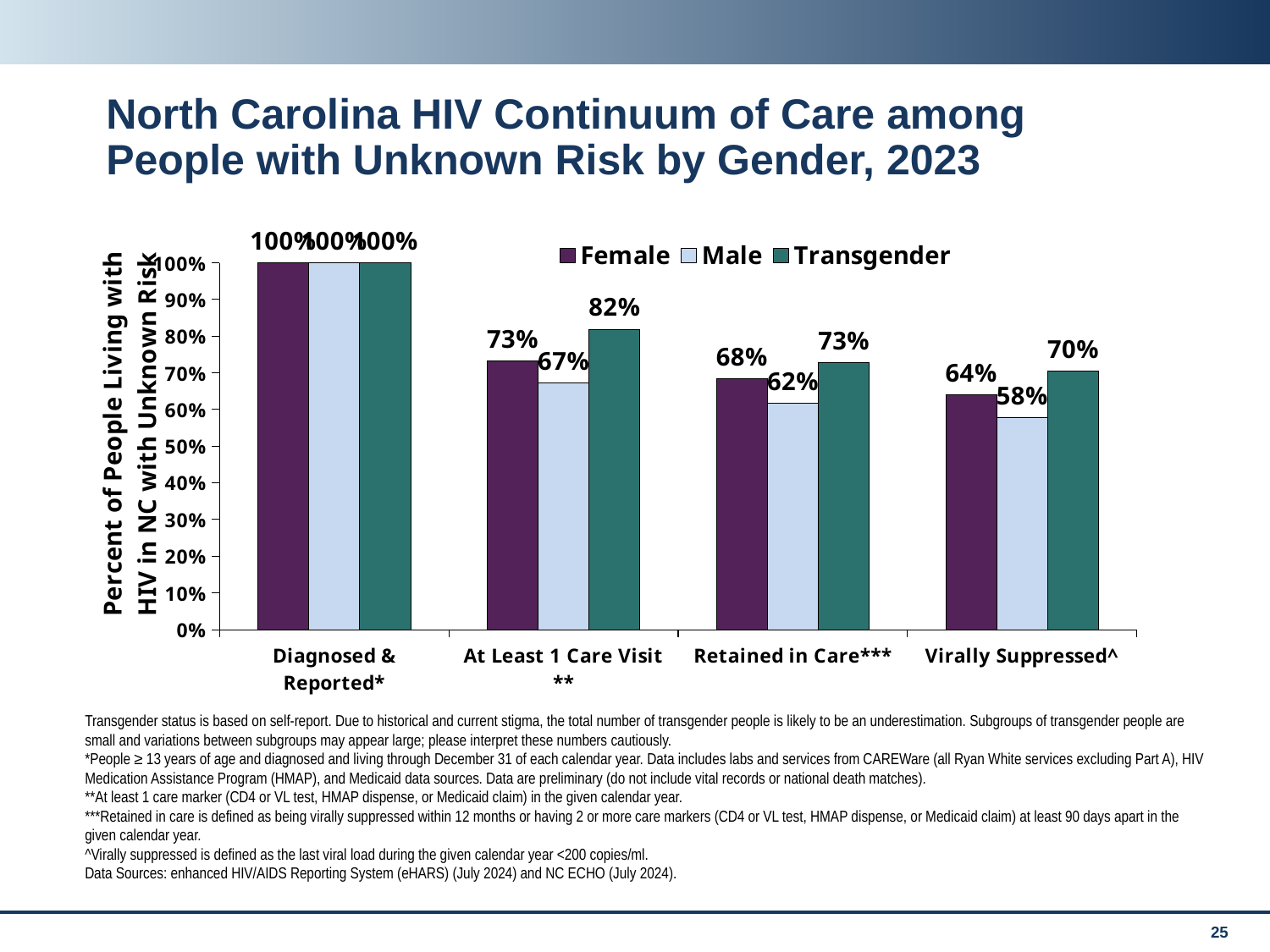
What percentage of Transgender people had at least 1 care visit? 82% What is the difference between the Female values for At Least 1 Care Visit and Virally Suppressed? 9% Is the Female value for Retained in Care larger or smaller than the Transgender value for Retained in Care? smaller How many series does the legend list? 3 What is the value for Male in the Virally Suppressed category? 58% Do the Male values rise or fall from Diagnosed & Reported to Virally Suppressed? fall What kind of chart is shown on the slide? bar chart How many categories are shown on the x axis? 4 What is the difference between the Transgender and Male values for Retained in Care? 11% Which gender has the highest value for Virally Suppressed? Transgender Which gender has the lowest value for At Least 1 Care Visit? Male What is the value for Female in the Retained in Care category? 68%